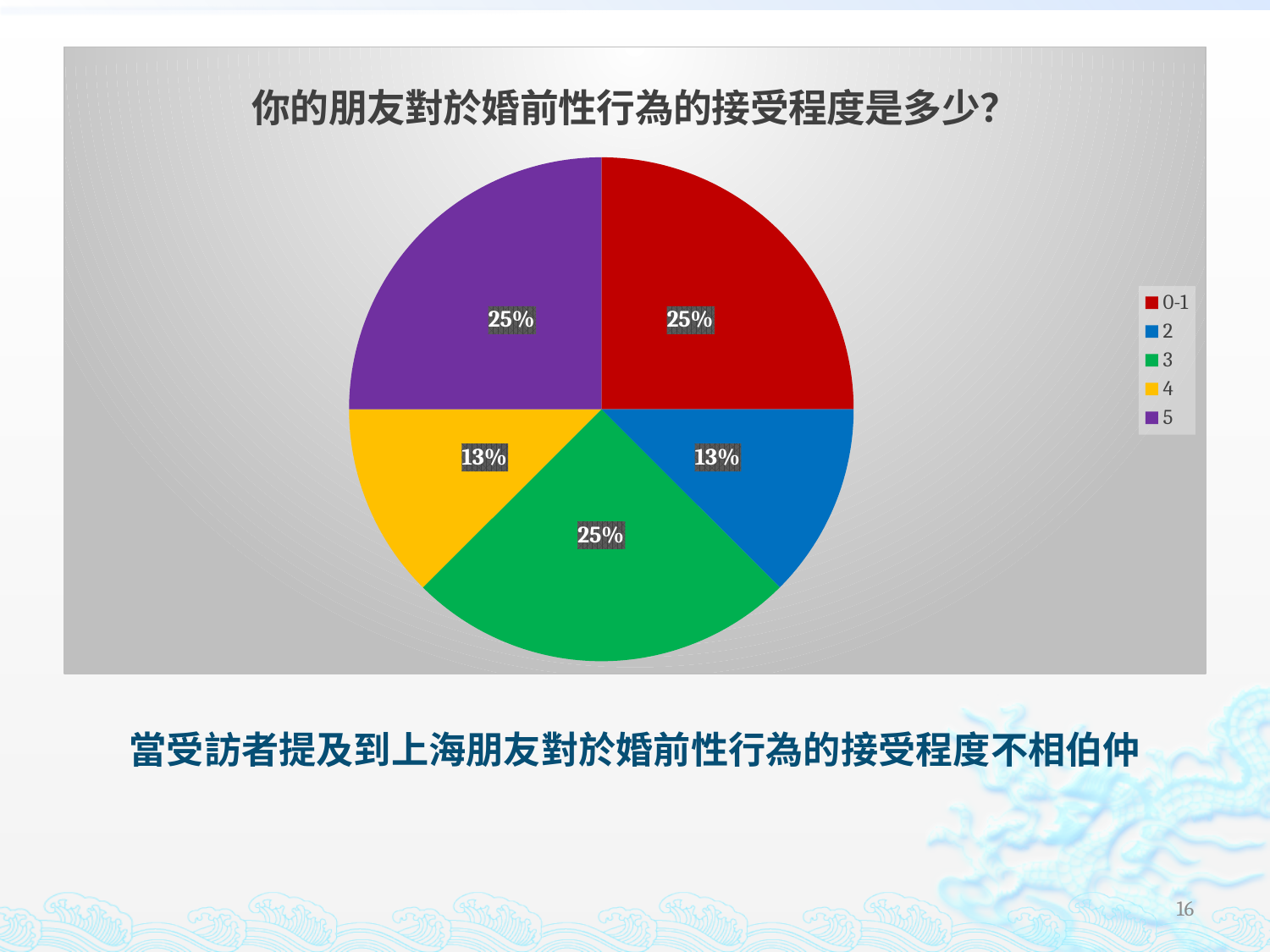
Which is larger, the share for category 0-1 or the share for category 2? 0-1 What is the title of the chart? 你的朋友對於婚前性行為的接受程度是多少? What share of the pie does the category 4 take? 13% What share of the pie does the category 3 take? 25% What share of the pie does the category 5 take? 25% What kind of chart is shown on the slide? pie chart Which colour represents category 5 in the legend? purple How many categories does the pie chart have? 5 Which is larger, the share for category 4 or the share for category 5? 5 What is the difference between the share for category 3 and the share for category 4? 12%